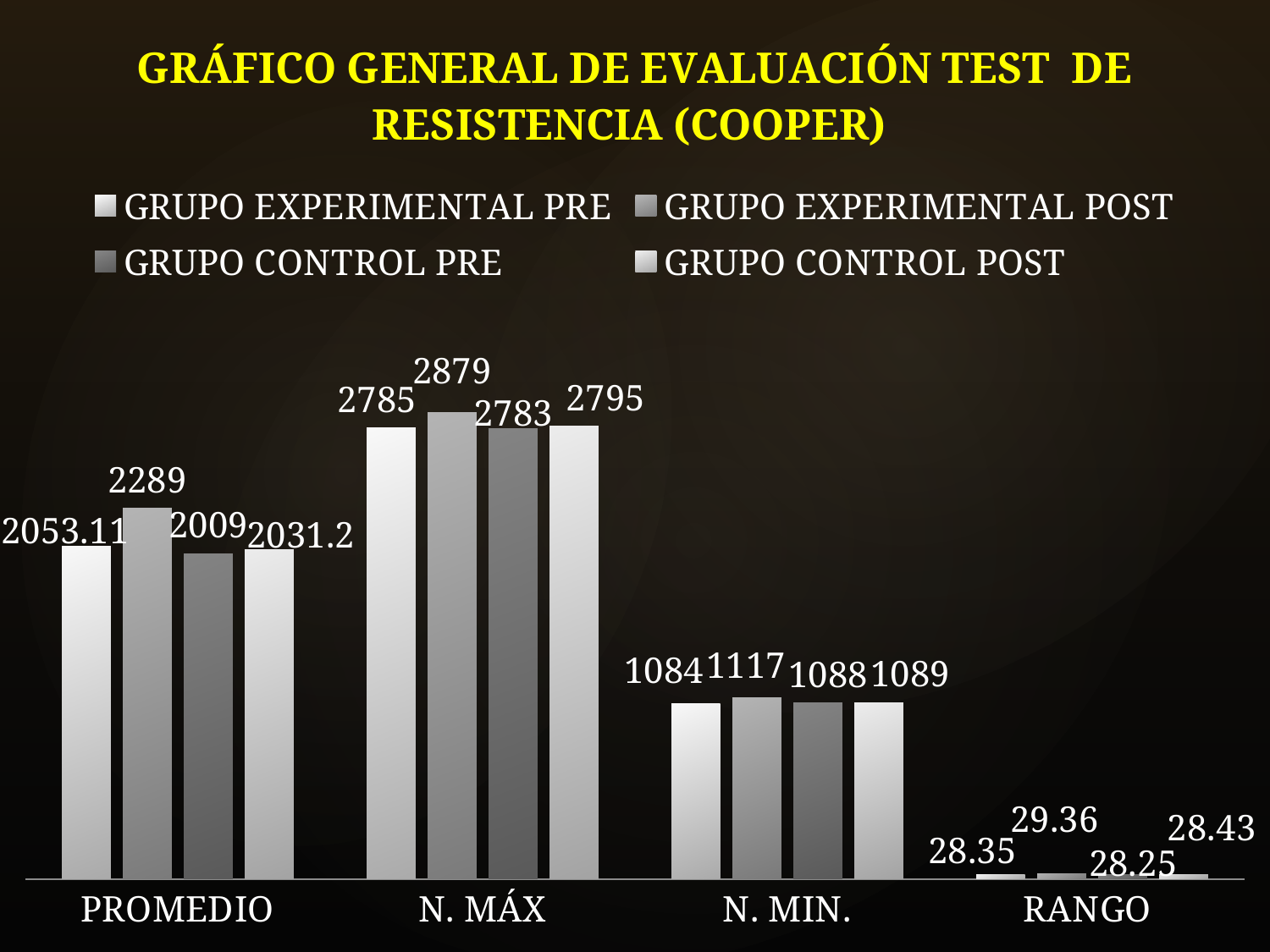
Which series has the highest value in the N. MÁX category? GRUPO EXPERIMENTAL POST How many categories are shown on the x axis? 4 Which series has the lowest value in the PROMEDIO category? GRUPO CONTROL PRE How many series does the legend list? 4 What is the title of the chart? GRÁFICO GENERAL DE EVALUACIÓN TEST DE RESISTENCIA (COOPER) What is the value for GRUPO CONTROL PRE in the N. MIN. category? 1088 What is the value for GRUPO EXPERIMENTAL PRE in the PROMEDIO category? 2053.11 What is the value for GRUPO EXPERIMENTAL POST in the PROMEDIO category? 2289 What is the value for GRUPO EXPERIMENTAL POST in the RANGO category? 29.36 What is the difference between the GRUPO EXPERIMENTAL POST and GRUPO EXPERIMENTAL PRE values in the N. MÁX category? 94 What is the value for GRUPO CONTROL POST in the N. MÁX category? 2795 What type of chart is shown on the slide? bar chart